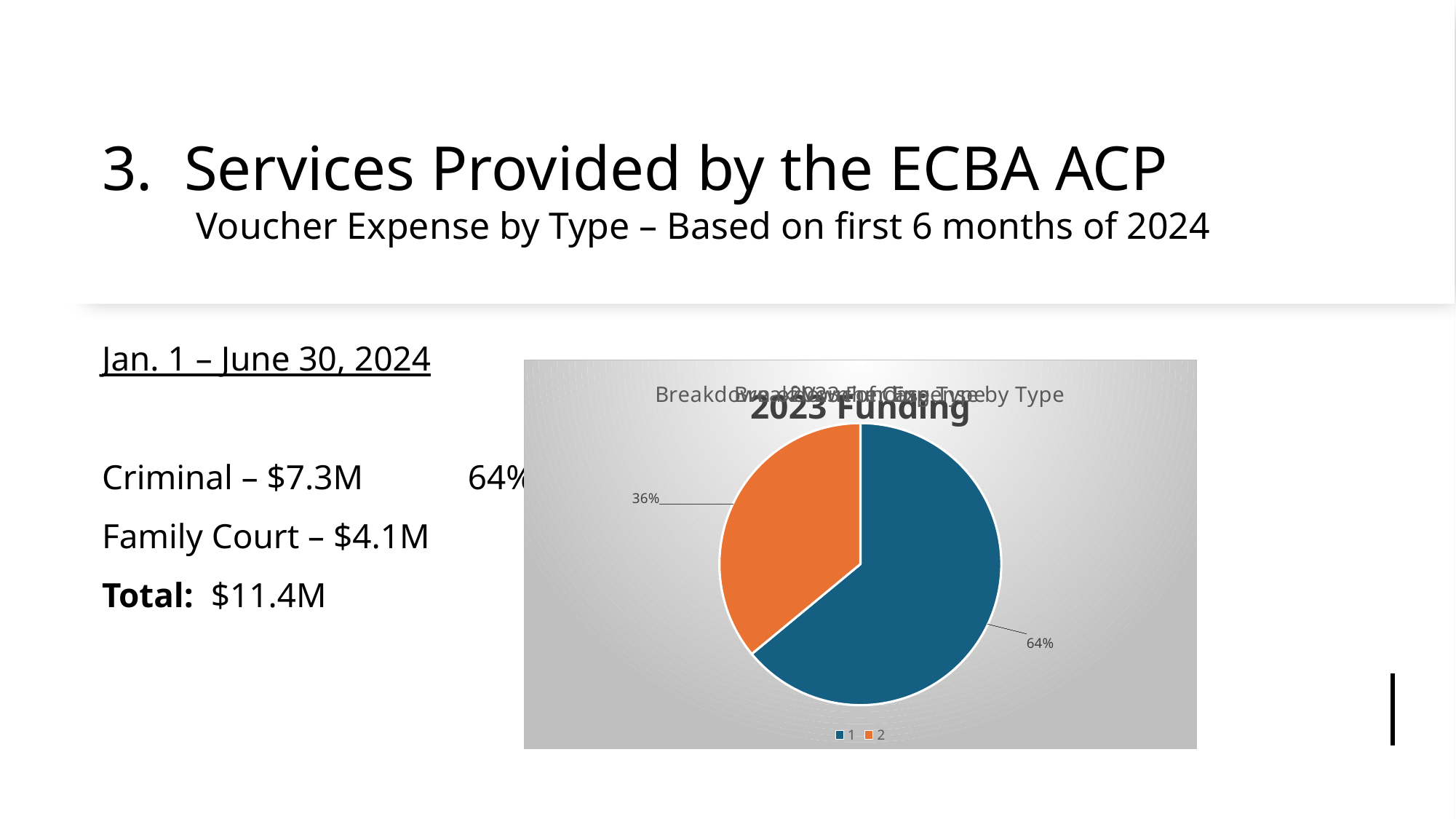
What share of the pie does the orange slice represent? 36% What is the difference in percentage points between the two slices of the pie chart? 28 Which is larger in the pie chart, the blue slice or the orange slice? the blue slice What colour is the slice labelled 64% in the pie chart? blue What percentage is shown for the blue slice (legend entry 1) of the pie chart? 64% What kind of chart is shown on the slide? pie chart What are the two legend entries shown below the pie chart? 1 and 2 How many entries does the pie chart's legend list? 2 How many slices does the pie chart have? 2 Which slice of the pie chart is the smallest? 2 (36%) What percentage is shown for the orange slice (legend entry 2) of the pie chart? 36% Which slice of the pie chart is the largest? 1 (64%)